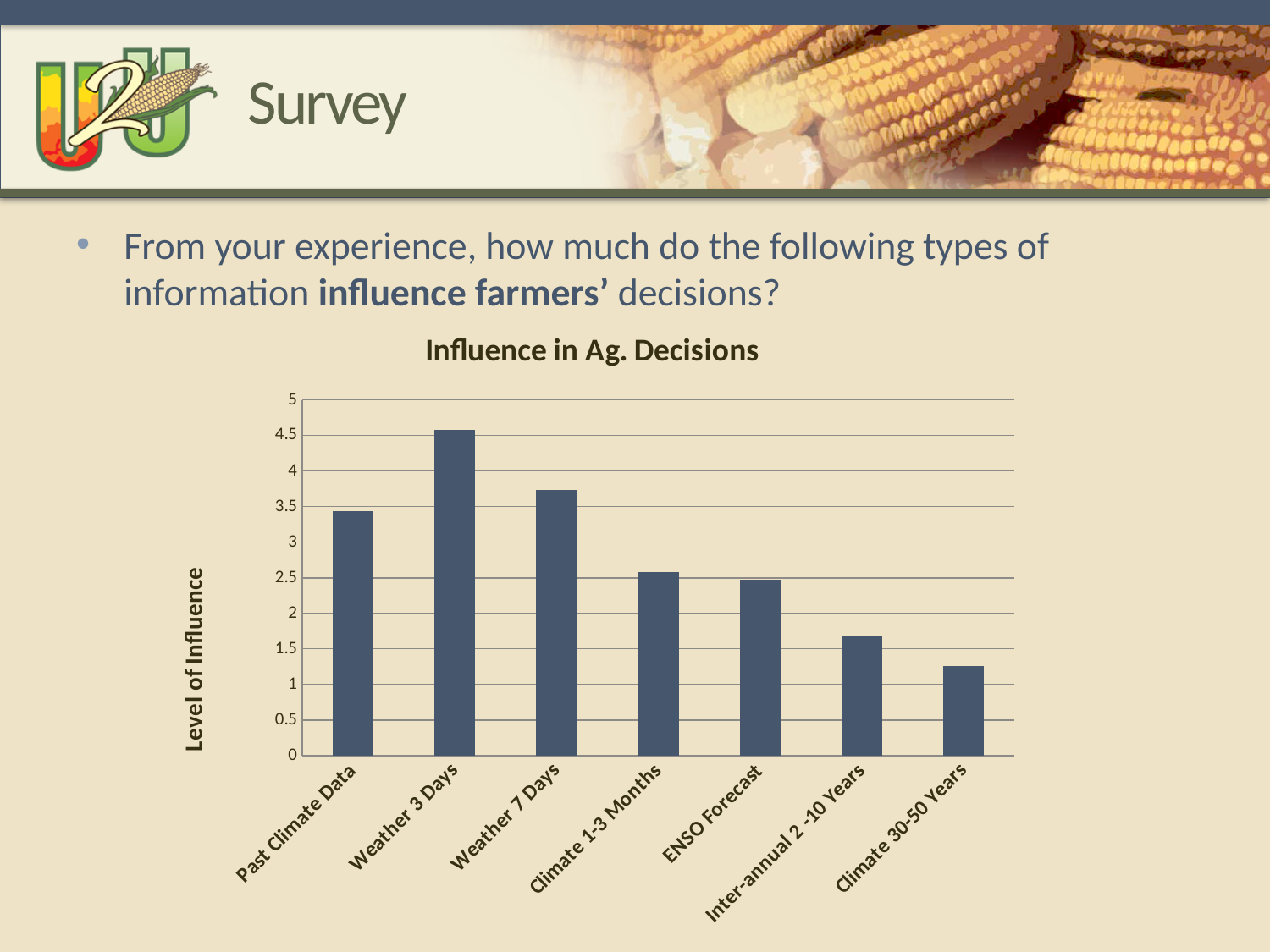
Which category has the lowest level of influence? Climate 30-50 Years How many categories are shown on the x axis of the chart? 7 Which has a higher level of influence, ENSO Forecast or Inter-annual 2 -10 Years? ENSO Forecast What is the title of the chart? Influence in Ag. Decisions Is the value for Weather 3 Days greater or less than 4.5? greater Which category has the highest level of influence? Weather 3 Days What type of chart is shown on the slide? bar chart What is the label on the vertical axis of the chart? Level of Influence Is the value for Past Climate Data greater or less than 3.5? less Which has a higher level of influence, Weather 7 Days or Past Climate Data? Weather 7 Days Is the value for Inter-annual 2 -10 Years greater or less than 1.5? greater